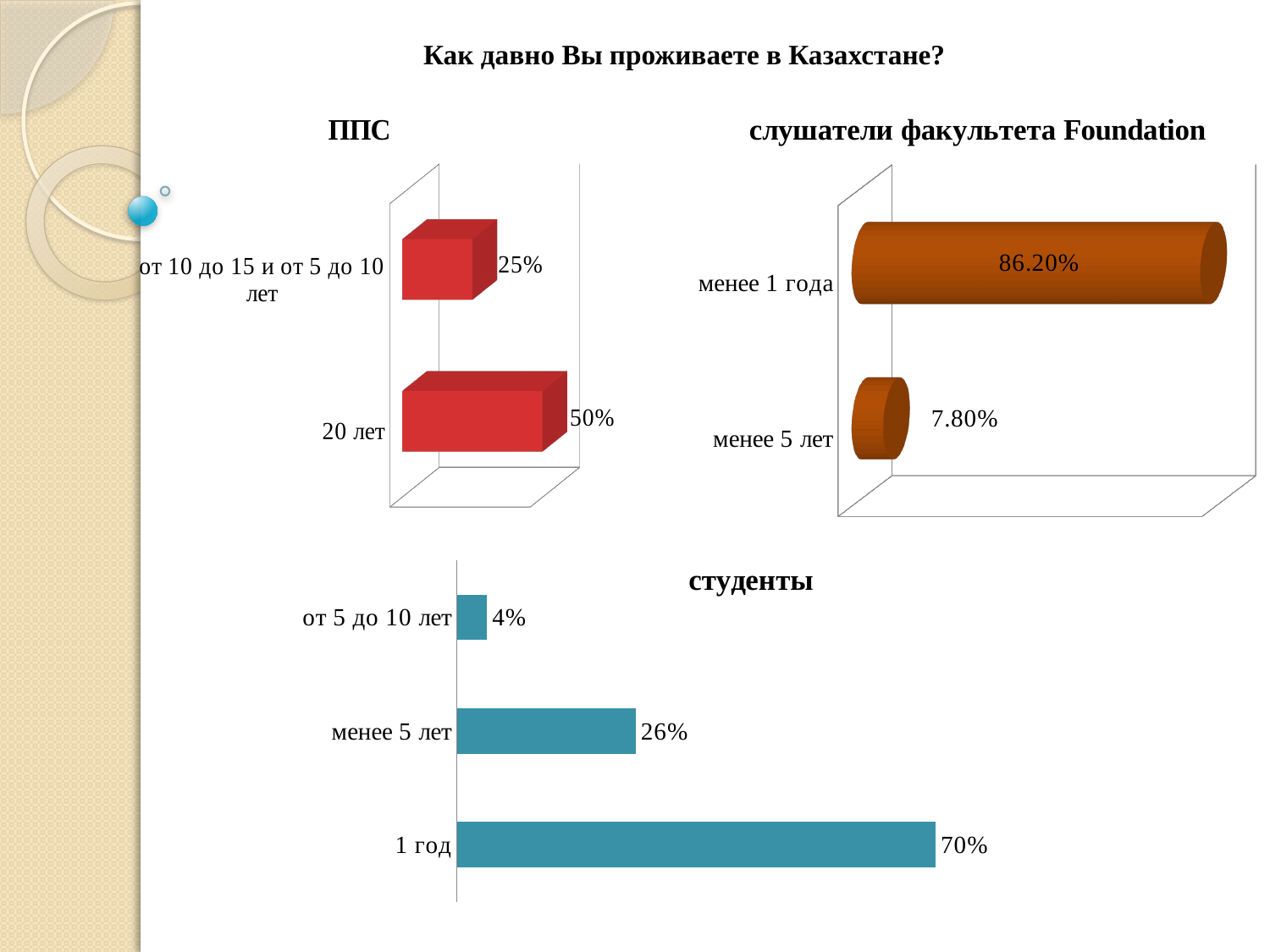
In the студенты chart, what is the difference between the values for 1 год and менее 5 лет? 44% In the слушатели факультета Foundation chart, how many categories are shown? 2 In the студенты chart, what is the value for менее 5 лет? 26% What kind of chart is the студенты chart? Bar chart In the ППС chart, what is the value for 20 лет? 50% In the слушатели факультета Foundation chart, which category has the highest value? менее 1 года In the студенты chart, which category has the lowest value? от 5 до 10 лет In the ППС chart, what is the value for от 10 до 15 и от 5 до 10 лет? 25% In the ППС chart, what is the difference between the values for 20 лет and от 10 до 15 и от 5 до 10 лет? 25% In the слушатели факультета Foundation chart, what is the value for менее 1 года? 86.20% In the слушатели факультета Foundation chart, what is the value for менее 5 лет? 7.80% In the студенты chart, what is the value for 1 год? 70%